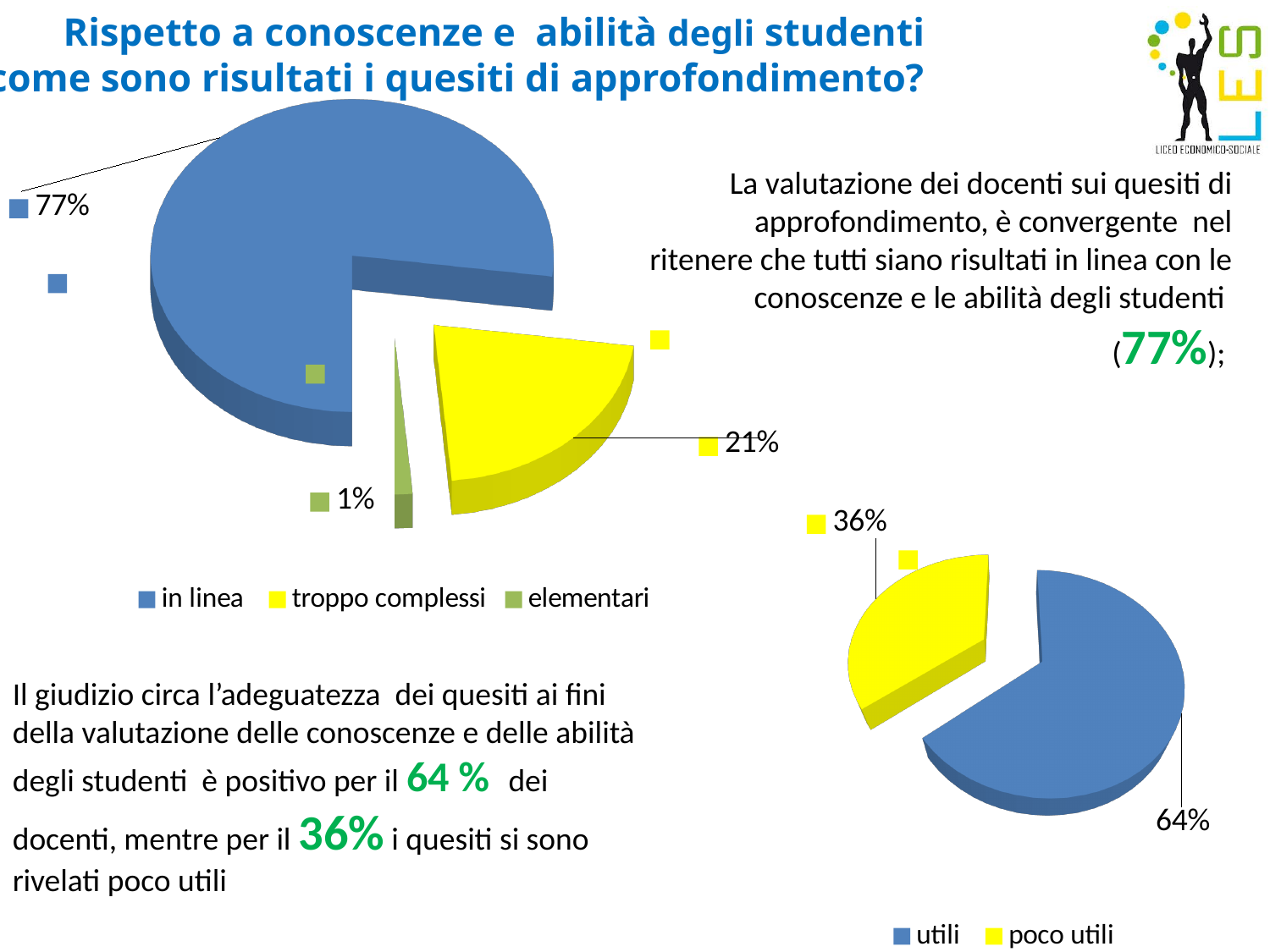
In the pie chart on the left, what percentage is shown for "troppo complessi"? 21% In the pie chart on the left, what is the difference in percentage points between "in linea" and "troppo complessi"? 56 In the pie chart on the lower right, what colour is the "poco utili" slice? yellow In the pie chart on the left, which category has the smallest share? elementari In the pie chart on the lower right, what percentage is shown for "poco utili"? 36% In the pie chart on the left, what percentage is shown for "elementari"? 1% How many categories does the legend of the pie chart on the left list? 3 In the pie chart on the left, what percentage is shown for "in linea"? 77% What type of chart is the chart on the lower right of the slide? pie chart In the pie chart on the lower right, which is larger, "utili" or "poco utili"? utili In the pie chart on the lower right, what percentage is shown for "utili"? 64% In the pie chart on the left, which category has the largest share? in linea